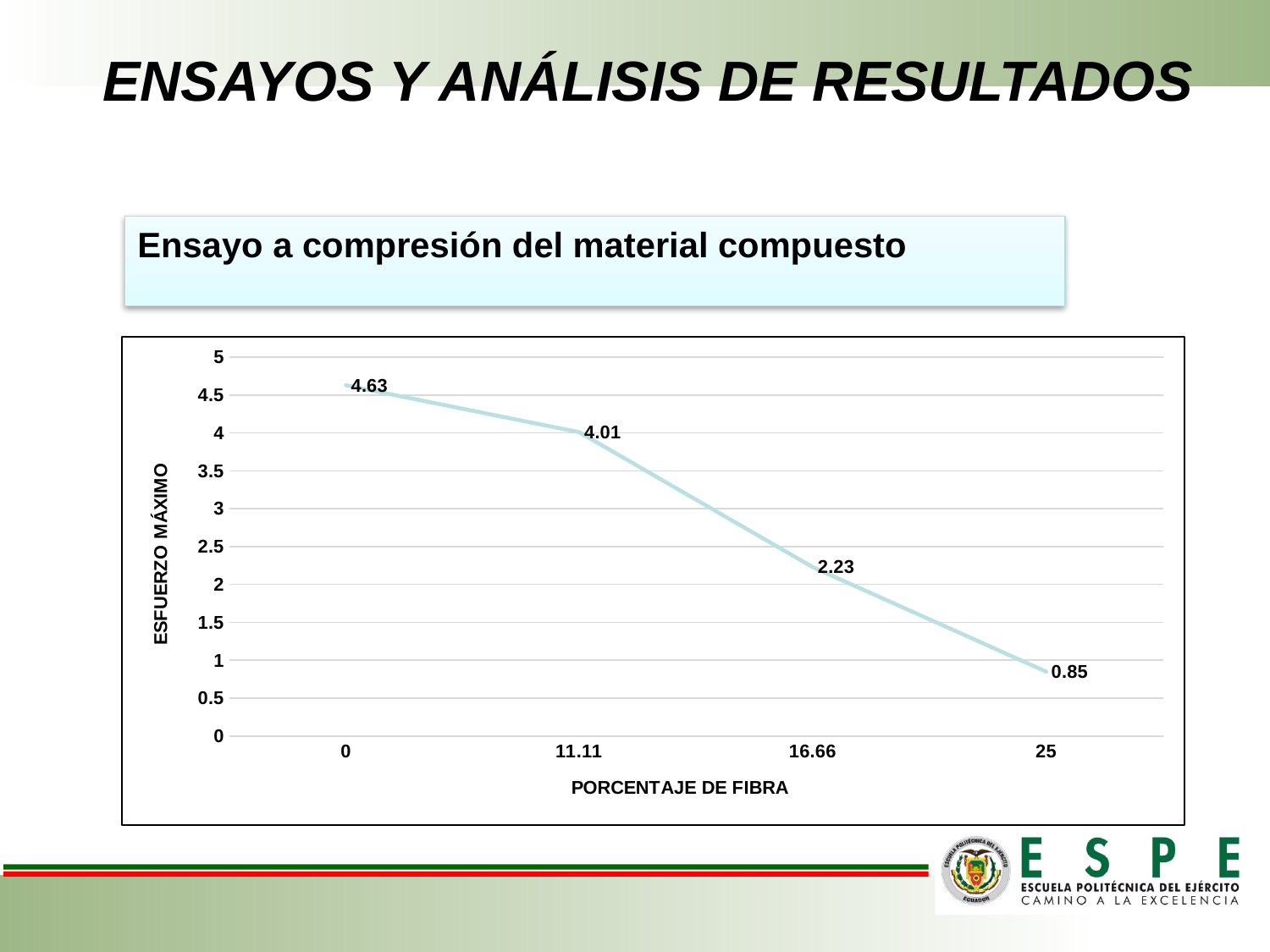
What is the ESFUERZO MÁXIMO value at a PORCENTAJE DE FIBRA of 25? 0.85 What is the difference in ESFUERZO MÁXIMO between a PORCENTAJE DE FIBRA of 11.11 and 16.66? 1.78 What is the ESFUERZO MÁXIMO value at a PORCENTAJE DE FIBRA of 11.11? 4.01 What is the difference in ESFUERZO MÁXIMO between a PORCENTAJE DE FIBRA of 0 and 25? 3.78 What kind of chart is shown on the slide? Line chart Does the ESFUERZO MÁXIMO rise or fall as the PORCENTAJE DE FIBRA increases? Fall At which PORCENTAJE DE FIBRA is the ESFUERZO MÁXIMO highest? 0 How many data points are plotted on the chart? 4 What is the ESFUERZO MÁXIMO value at a PORCENTAJE DE FIBRA of 16.66? 2.23 At which PORCENTAJE DE FIBRA is the ESFUERZO MÁXIMO lowest? 25 What is the ESFUERZO MÁXIMO value at a PORCENTAJE DE FIBRA of 0? 4.63 Which has a larger ESFUERZO MÁXIMO: a PORCENTAJE DE FIBRA of 11.11 or 16.66? 11.11